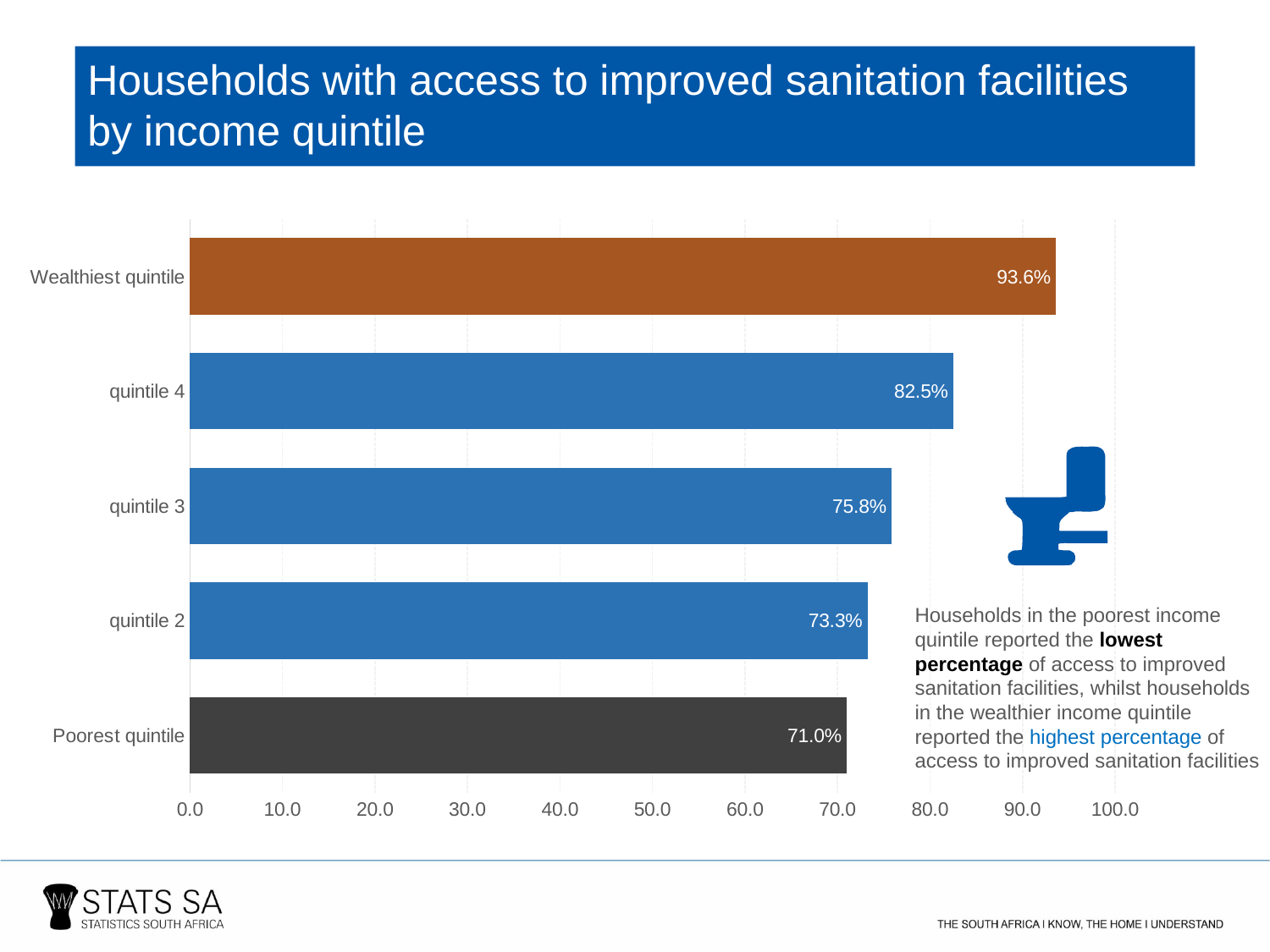
Which income quintile has the highest percentage of households with access to improved sanitation facilities? Wealthiest quintile What is the difference in percentage points between quintile 4 and quintile 2? 9.2 Which income quintile has the lowest percentage of households with access to improved sanitation facilities? Poorest quintile What is the value shown for quintile 3? 75.8% Which bar is coloured orange-brown rather than blue or grey? Wealthiest quintile How many income quintiles are shown in the chart? 5 What percentage of households in the wealthiest quintile have access to improved sanitation facilities? 93.6% Which has a higher value, quintile 2 or quintile 3? quintile 3 What is the difference in percentage points between the wealthiest quintile and the poorest quintile? 22.6 Is the value for quintile 4 greater or less than 80.0? greater What is the value shown for the poorest quintile? 71.0% What kind of chart is shown on the slide? Bar chart